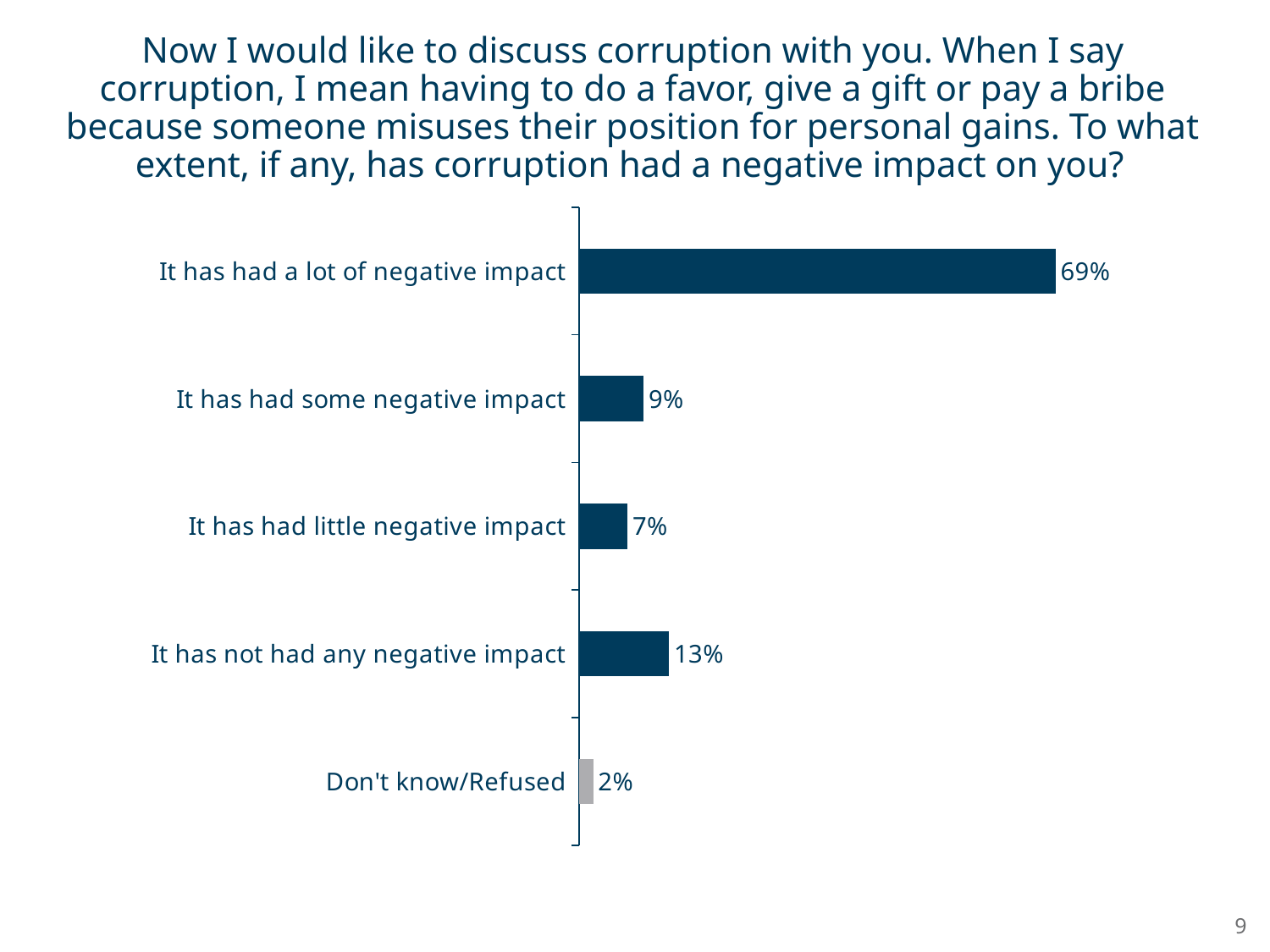
What is the value for "Don't know/Refused"? 2% Which response category has the highest value? It has had a lot of negative impact Which response category has the lowest value? Don't know/Refused What percentage of respondents said corruption has had a lot of negative impact on them? 69% What kind of chart is shown on the slide? Bar chart What percentage said corruption has not had any negative impact on them? 13% What is the value for "It has had little negative impact"? 7% Which is larger: "It has had some negative impact" or "It has had little negative impact"? It has had some negative impact How many response categories are shown in the chart? 5 What is the difference between "It has had a lot of negative impact" and "It has not had any negative impact"? 56 percentage points Which bar is shown in a different colour (grey) from the others? Don't know/Refused What is the value for "It has had some negative impact"? 9%